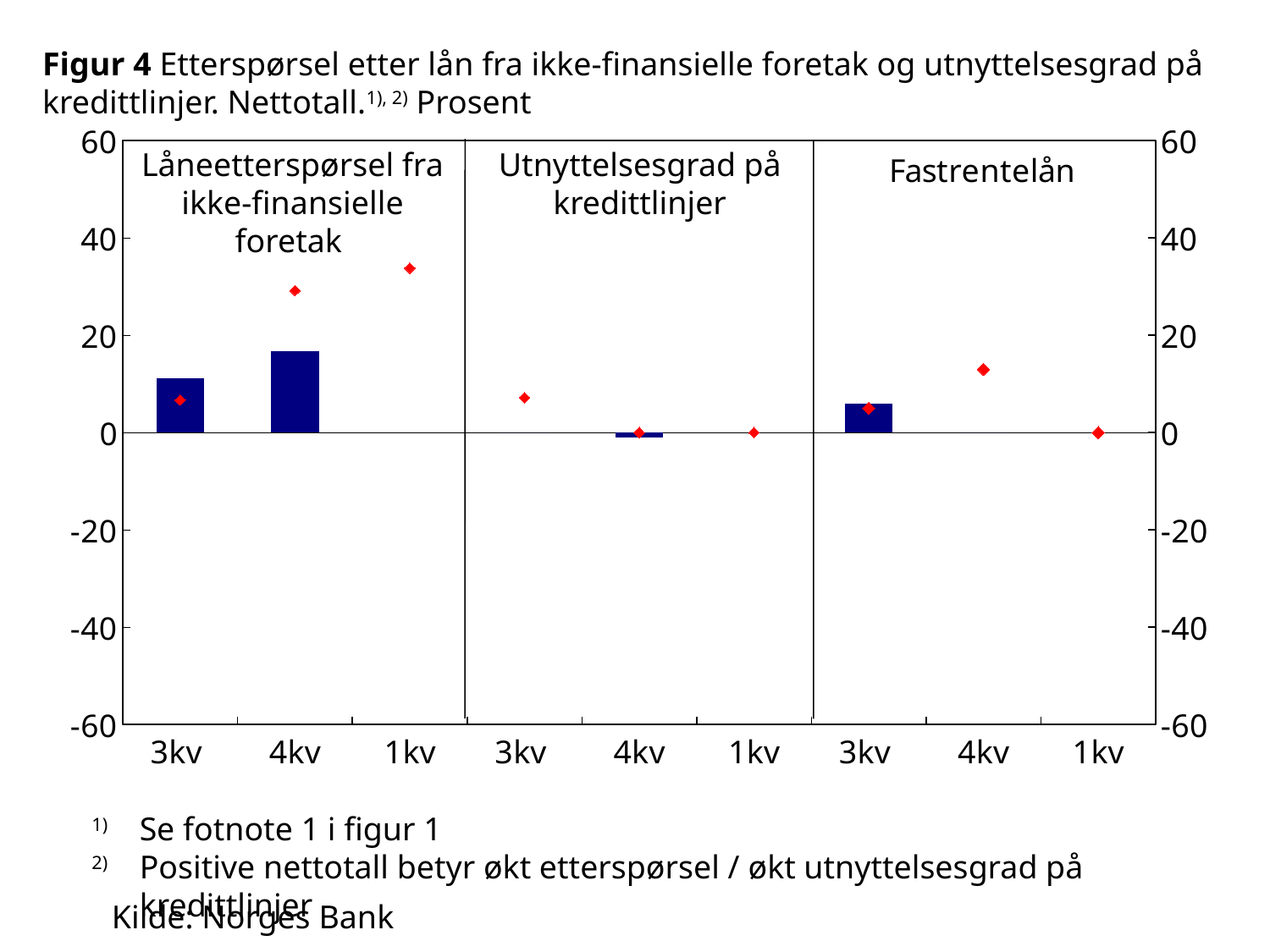
In the 'Låneetterspørsel fra ikke-finansielle foretak' panel, is the red diamond for 1kv greater or less than 20? greater In the 'Låneetterspørsel fra ikke-finansielle foretak' panel, is the bar for 4kv greater or less than 20? less How many quarters are shown on the x axis of each panel? 3 In the 'Fastrentelån' panel, is the red diamond for 4kv greater or less than 20? less In the 'Låneetterspørsel fra ikke-finansielle foretak' panel, do the red diamond markers rise or fall from 3kv to 1kv? rise In the 'Fastrentelån' panel, which quarter has the highest red diamond marker? 4kv What is the title of the middle panel of the chart? Utnyttelsesgrad på kredittlinjer What kind of chart is shown on the slide? combination bar and line chart (bars with diamond markers) How many panels (sections) does the chart have? 3 In the 'Låneetterspørsel fra ikke-finansielle foretak' panel, which quarter has the highest red diamond marker? 1kv In the 'Låneetterspørsel fra ikke-finansielle foretak' panel, which bar is taller, 3kv or 4kv? 4kv What is the title of the right-hand panel of the chart? Fastrentelån